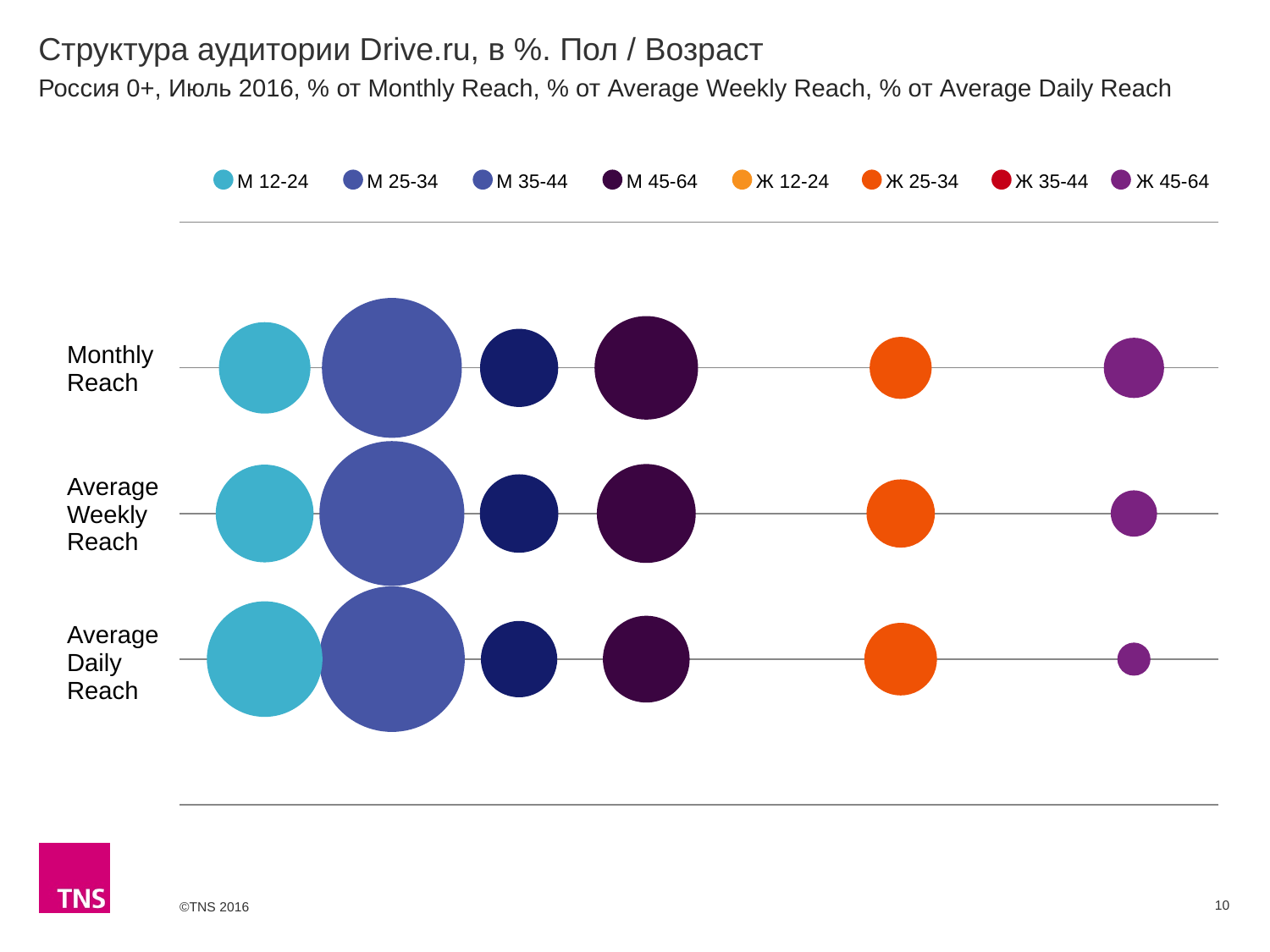
How many reach categories (rows) are plotted on the chart? 3 Which audience group has the smallest bubble in the Average Daily Reach row? Ж 45-64 Which audience group has the largest bubble in the Monthly Reach row? М 25-34 What is the title of the chart on the slide? Структура аудитории Drive.ru, в %. Пол / Возраст Does the bubble for М 12-24 get larger or smaller going from Monthly Reach to Average Daily Reach? Larger Does the bubble for Ж 45-64 get larger or smaller going from Monthly Reach to Average Daily Reach? Smaller Which audience group has the largest bubble in the Average Daily Reach row? М 25-34 How many series does the legend list? 8 In the Monthly Reach row, which bubble is larger: М 45-64 or Ж 25-34? М 45-64 What kind of chart is shown on the slide? Bubble chart Which legend entry is shown in red? Ж 35-44 In the Monthly Reach row, which bubble is larger: М 12-24 or М 35-44? М 12-24